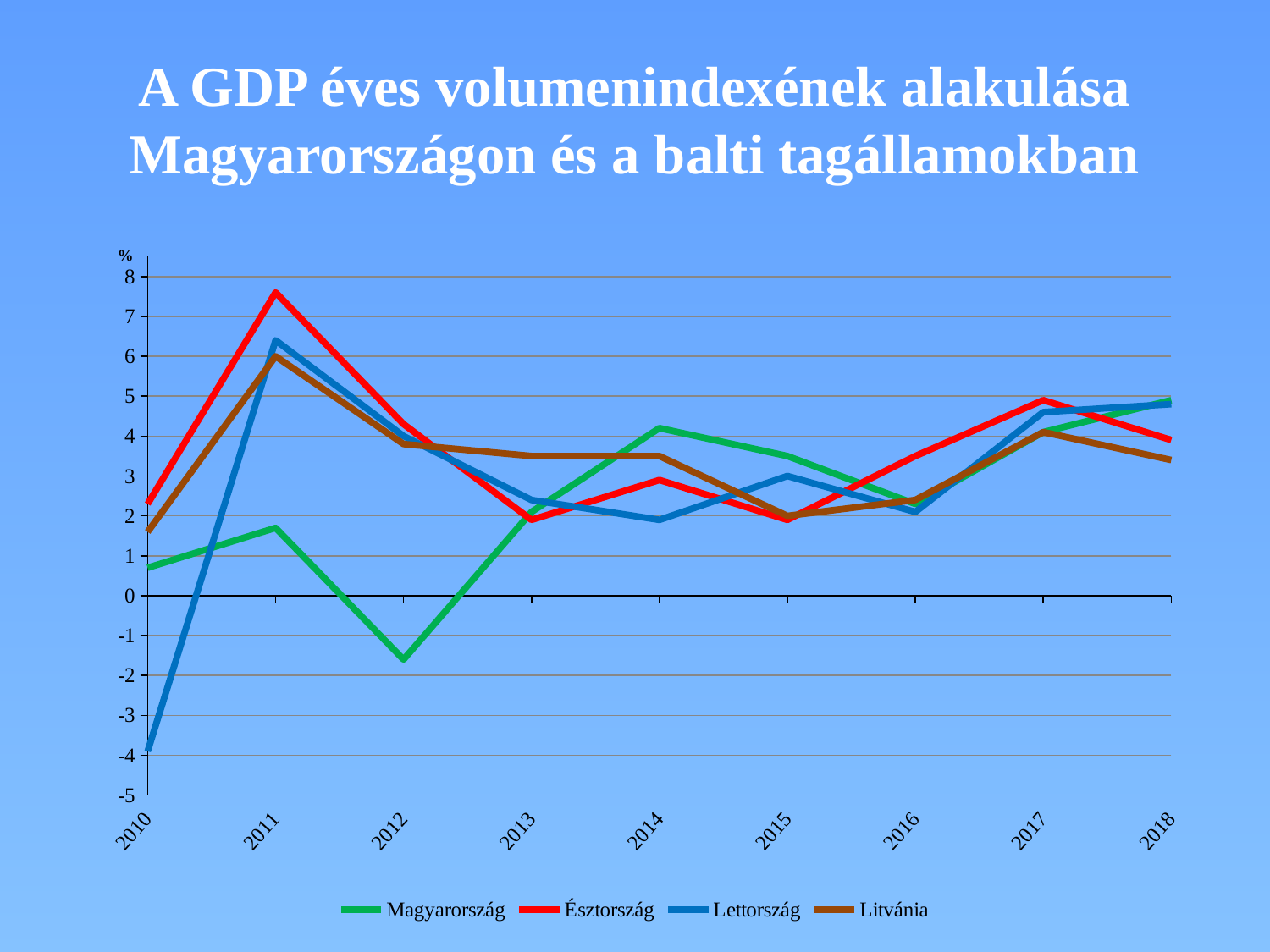
Does the value for Magyarország rise or fall from 2012 to 2014? rise How many series does the legend list? 4 What kind of chart is shown on the slide? line chart Which country has the lowest value in 2010? Lettország In 2014, which is larger: the value for Magyarország or the value for Lettország? Magyarország Is the value for Észtország in 2011 greater or less than 7? greater Which country has the highest value in 2011? Észtország In which year does Magyarország reach its lowest value? 2012 Is the value for Magyarország in 2012 greater or less than 0? less Is the value for Litvánia in 2011 greater or less than 5? greater How many years are shown on the x axis? 9